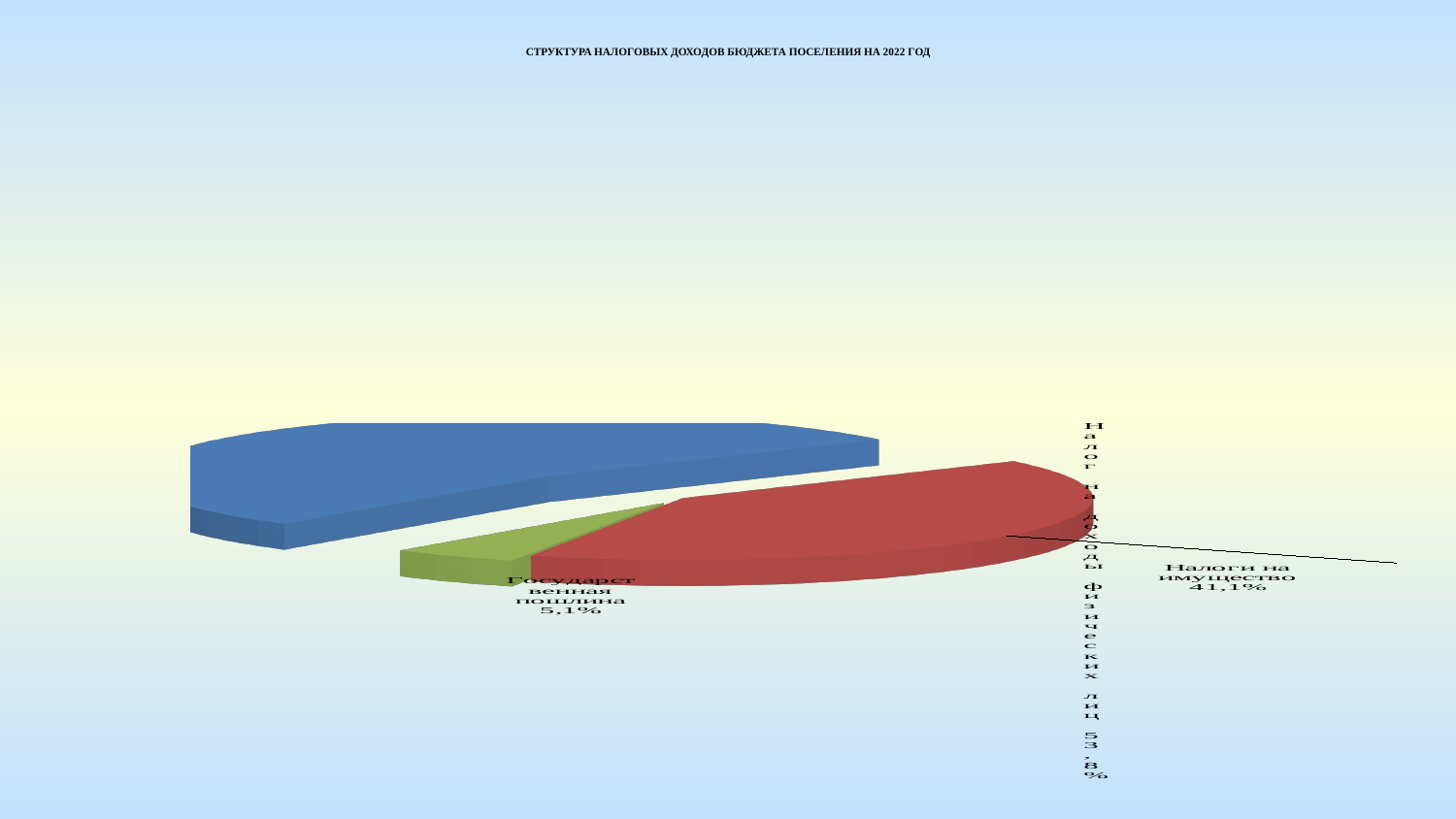
What is the title of the chart? СТРУКТУРА НАЛОГОВЫХ ДОХОДОВ БЮДЖЕТА ПОСЕЛЕНИЯ НА 2022 ГОД What is the difference in percentage points between Налог на доходы физических лиц and Налоги на имущество? 12,7 Is the share for Налоги на имущество greater or less than 50%? less How many slices does the pie chart have? 3 What share of the pie is labelled for Налог на доходы физических лиц? 53,8% What colour is the slice for Государственная пошлина? Green Which is larger: the share for Налоги на имущество or the share for Государственная пошлина? Налоги на имущество Which category has the largest share of the pie? Налог на доходы физических лиц Which category has the smallest share of the pie? Государственная пошлина What share of the pie is labelled for Налоги на имущество? 41,1% What share of the pie is labelled for Государственная пошлина? 5,1% What kind of chart is shown on the slide? Pie chart